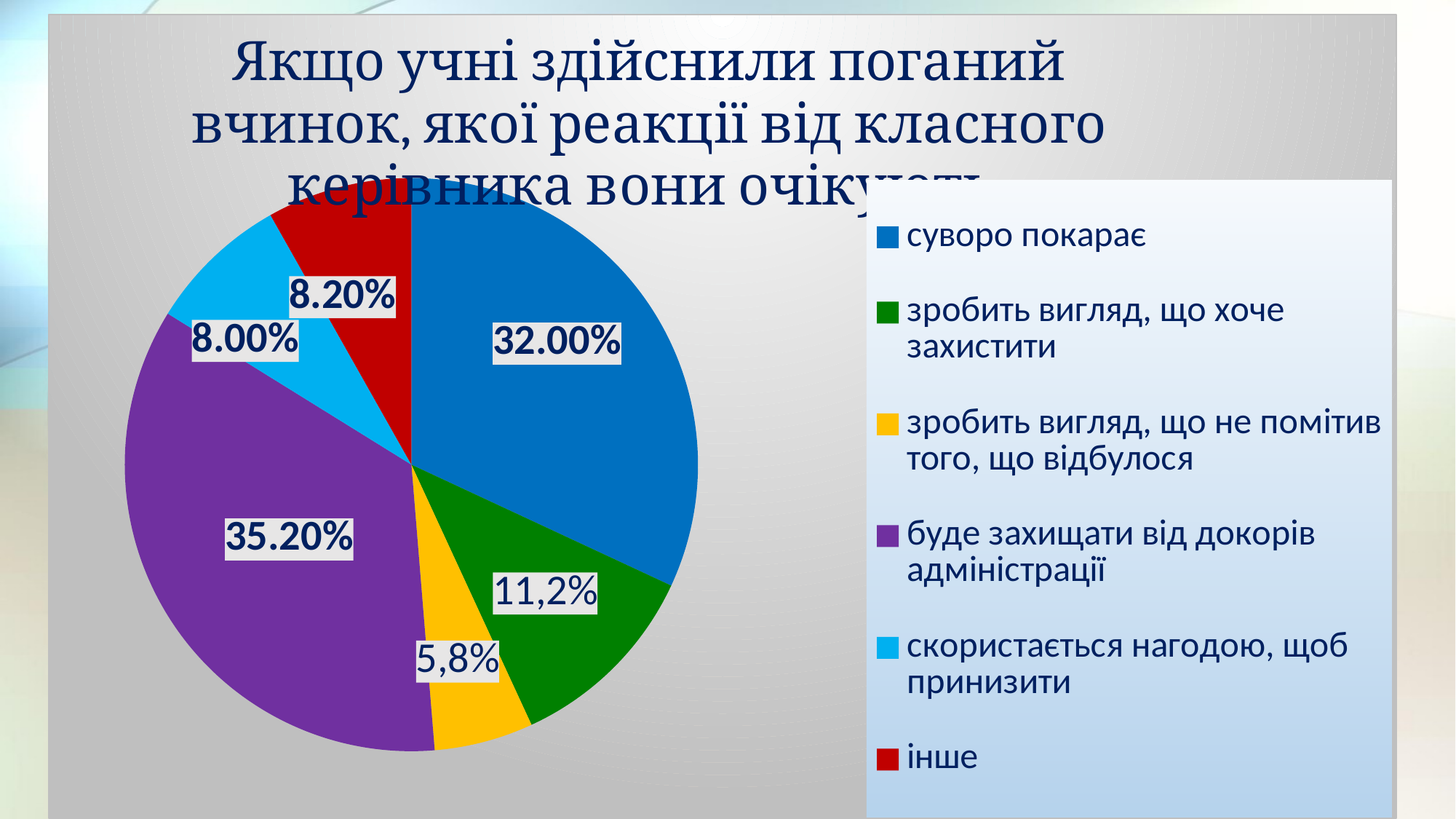
What type of chart is shown on the slide? pie chart What percentage is labelled on the slice "зробить вигляд, що хоче захистити"? 11,2% What is the difference between the shares for "буде захищати від докорів адміністрації" and "суворо покарає"? 3.20% How many slices does the pie chart have? 6 What percentage is shown for the slice "скористається нагодою, щоб принизити"? 8.00% Which is larger: the share for "суворо покарає" or for "зробить вигляд, що хоче захистити"? суворо покарає Which category has the largest share of the pie chart? буде захищати від докорів адміністрації What percentage of the pie chart is the slice for "суворо покарає"? 32.00% What value is shown for "зробить вигляд, що не помітив того, що відбулося"? 5,8% What value is labelled on the "інше" slice? 8.20% What value is shown for the slice "буде захищати від докорів адміністрації"? 35.20% Which category has the smallest share of the pie chart? зробить вигляд, що не помітив того, що відбулося